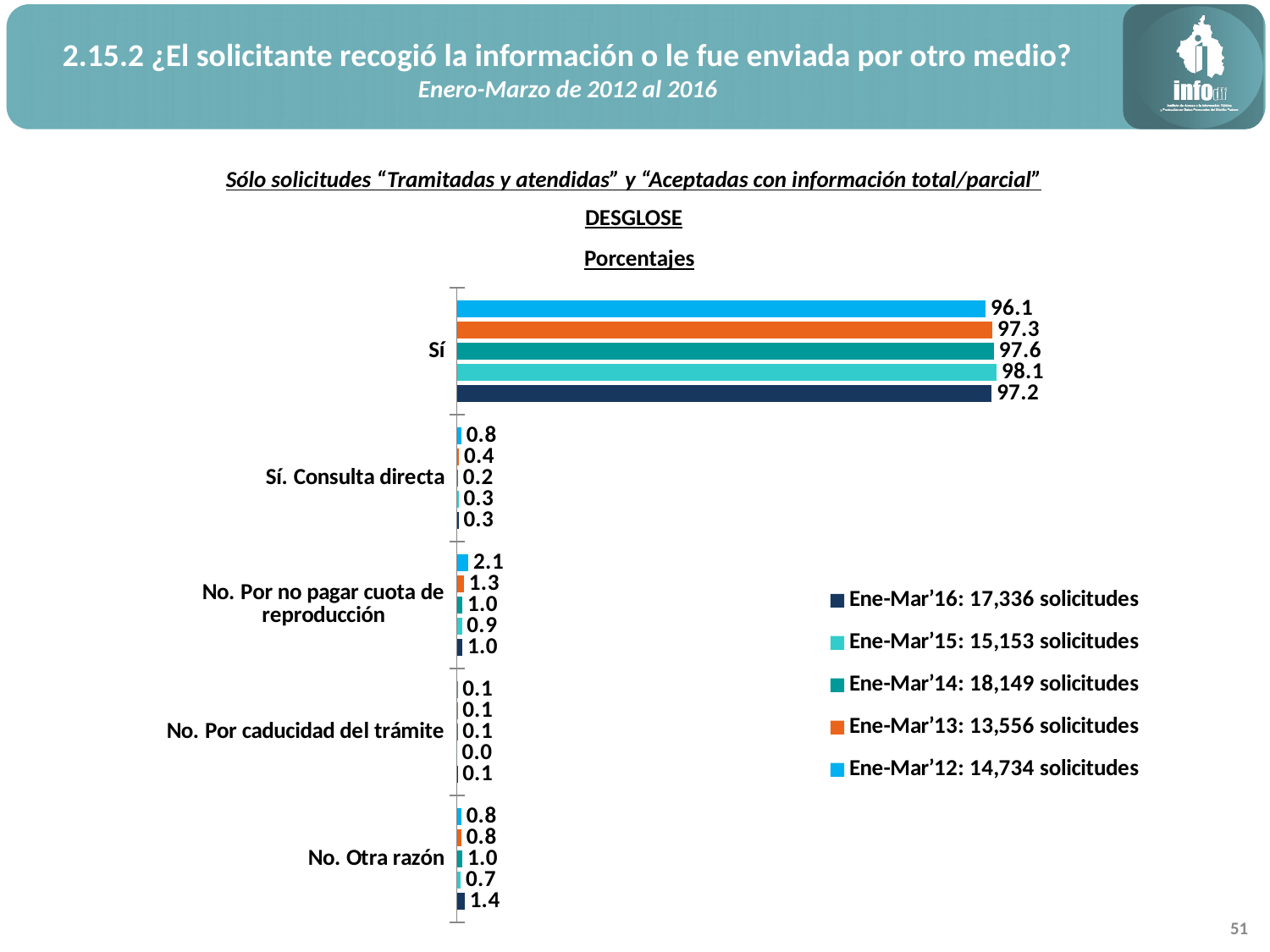
What is the value for "No. Por no pagar cuota de reproducción" in the Ene-Mar'12 series? 2.1 What is the value for "Sí" in the Ene-Mar'15 series? 98.1 What is the value for "No. Otra razón" in the Ene-Mar'16 series? 1.4 According to the legend, how many solicitudes does the Ene-Mar'16 series represent? 17,336 solicitudes What is the difference between the Ene-Mar'15 and Ene-Mar'12 values for "Sí"? 2.0 How many series does the legend list? 5 How many categories are shown on the chart? 5 Which series has the highest value for "Sí"? Ene-Mar'15 What type of chart is shown on the slide? bar chart What is the value for "Sí" in the Ene-Mar'12 series? 96.1 For "Sí. Consulta directa", which is larger: the Ene-Mar'12 value or the Ene-Mar'14 value? Ene-Mar'12 Which series has the lowest value for "Sí"? Ene-Mar'12